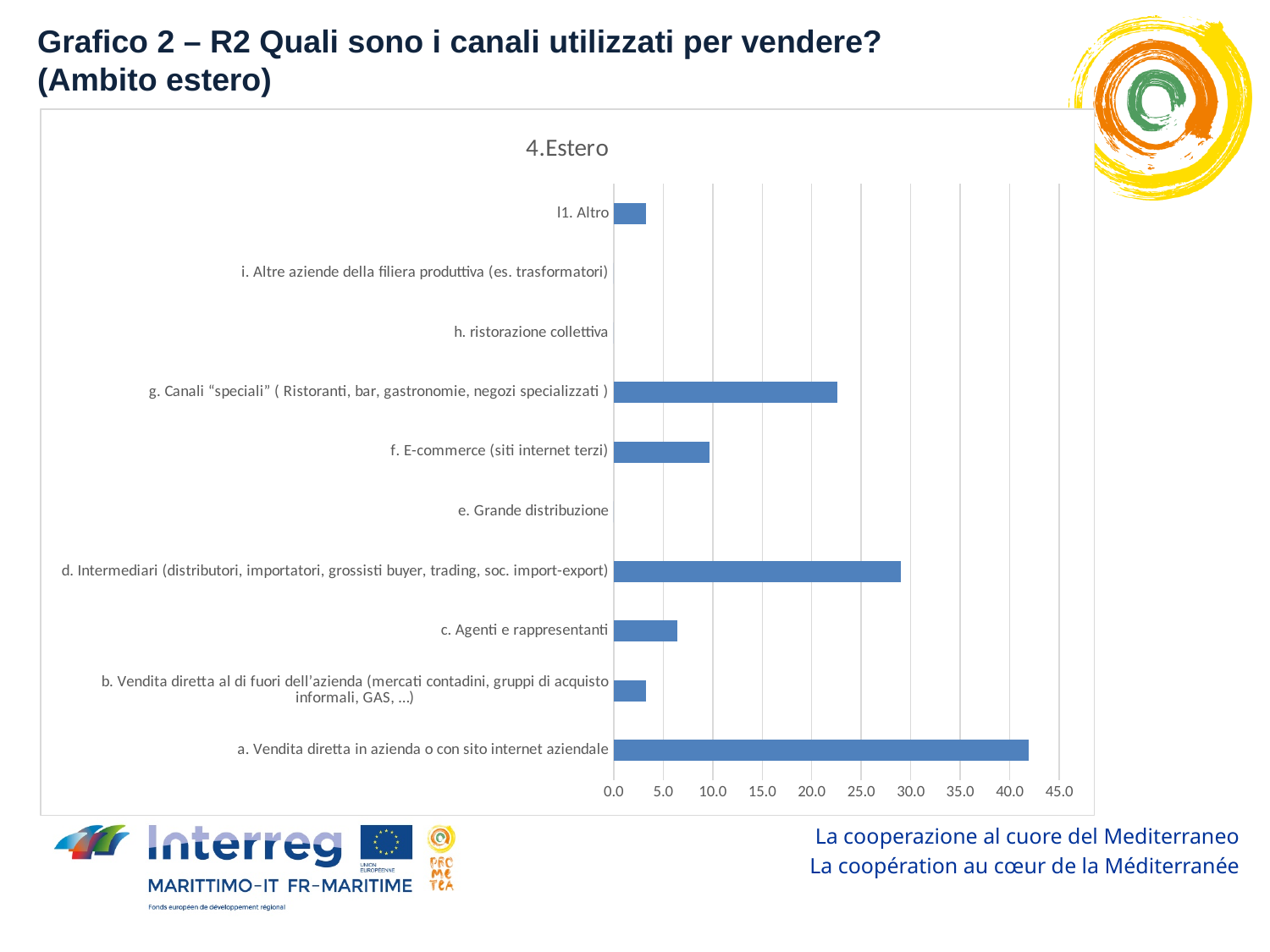
Which has a larger value: 'd. Intermediari' or 'g. Canali "speciali"'? d. Intermediari Is the value for 'a. Vendita diretta in azienda o con sito internet aziendale' greater or less than 40.0? greater What kind of chart is shown on the slide? bar chart How many categories in the chart show no visible bar? 3 What is the title shown above the chart? 4.Estero Is the value for 'f. E-commerce (siti internet terzi)' greater or less than 5.0? greater Which category has the highest value in the chart? a. Vendita diretta in azienda o con sito internet aziendale Is the value for 'd. Intermediari (distributori, importatori, grossisti buyer, trading, soc. import-export)' greater or less than 25.0? greater Which has a larger value: 'c. Agenti e rappresentanti' or 'f. E-commerce (siti internet terzi)'? f. E-commerce (siti internet terzi) How many categories are listed on the vertical axis of the chart? 10